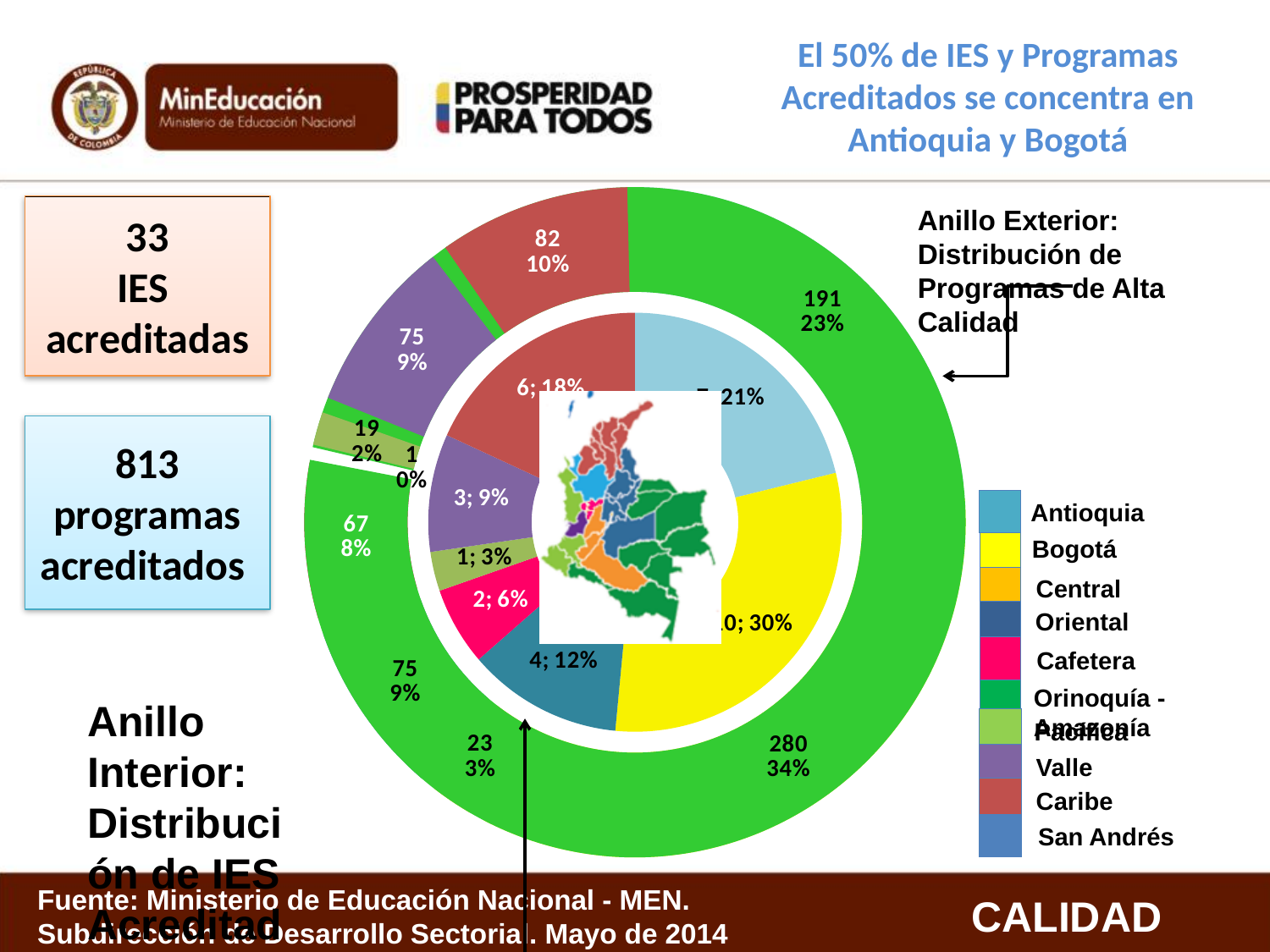
How many entries does the legend list? 10 In the inner ring, what is the difference between the Bogotá segment (10) and the Antioquia segment (7)? 3 In the outer ring (Programas de Alta Calidad), what is the largest value shown? 280 (34%) In the inner ring, what value and share are shown for the light blue (Antioquia) segment? 7; 21% In the inner ring, what value and share are shown for the yellow (Bogotá) segment? 10; 30% In the inner ring (IES acreditadas), what is the smallest value shown? 1 (3%) In the outer ring, which is larger: the segment labelled 280 or the segment labelled 191? 280 According to the slide, what does the outer ring (Anillo Exterior) represent? Distribución de Programas de Alta Calidad In the outer ring, what value and share are shown for the purple (Valle) segment? 75, 9% In the outer ring, what value and share are shown for the red (Caribe) segment? 82, 10% What is the total of the values shown in the inner ring (6, 7, 10, 4, 2, 1, 3)? 33 What kind of chart is shown on the slide? Doughnut (pie) chart with two rings